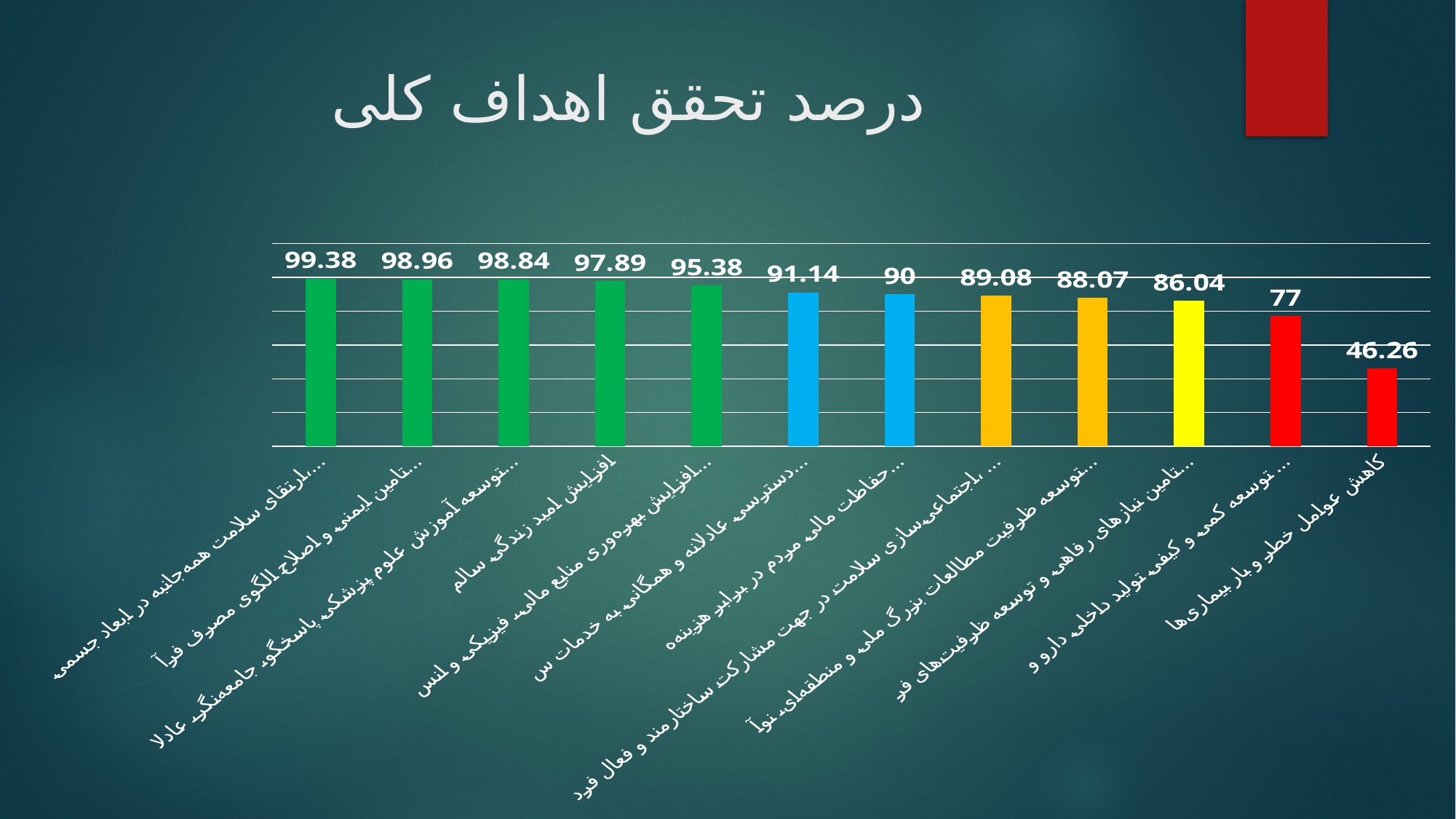
Which category has the lowest value? کاهش عوامل خطر و بار بیماری‌ها Which category has the highest value? ارتقای سلامت همه‌جانبه در ابعاد جسمی... What is the title of the chart? درصد تحقق اهداف کلی What is the value for the category 'توسعه کمی و کیفی تولید داخلی دارو و...'? 77 What type of chart is shown on the slide? bar chart What is the value for the category 'افزایش امید زندگی سالم'? 97.89 Which is larger: the value for 'حفاظت مالی مردم در برابر هزینه...' or the value for 'توسعه کمی و کیفی تولید داخلی دارو و...'? حفاظت مالی مردم در برابر هزینه... Do the values rise or fall from left to right across the chart? fall What is the difference between the highest value (99.38) and the lowest value (46.26)? 53.12 What is the value for the category 'کاهش عوامل خطر و بار بیماری‌ها'? 46.26 How many bars (categories) does the chart show? 12 What colour is the bar for the lowest value, 46.26? red